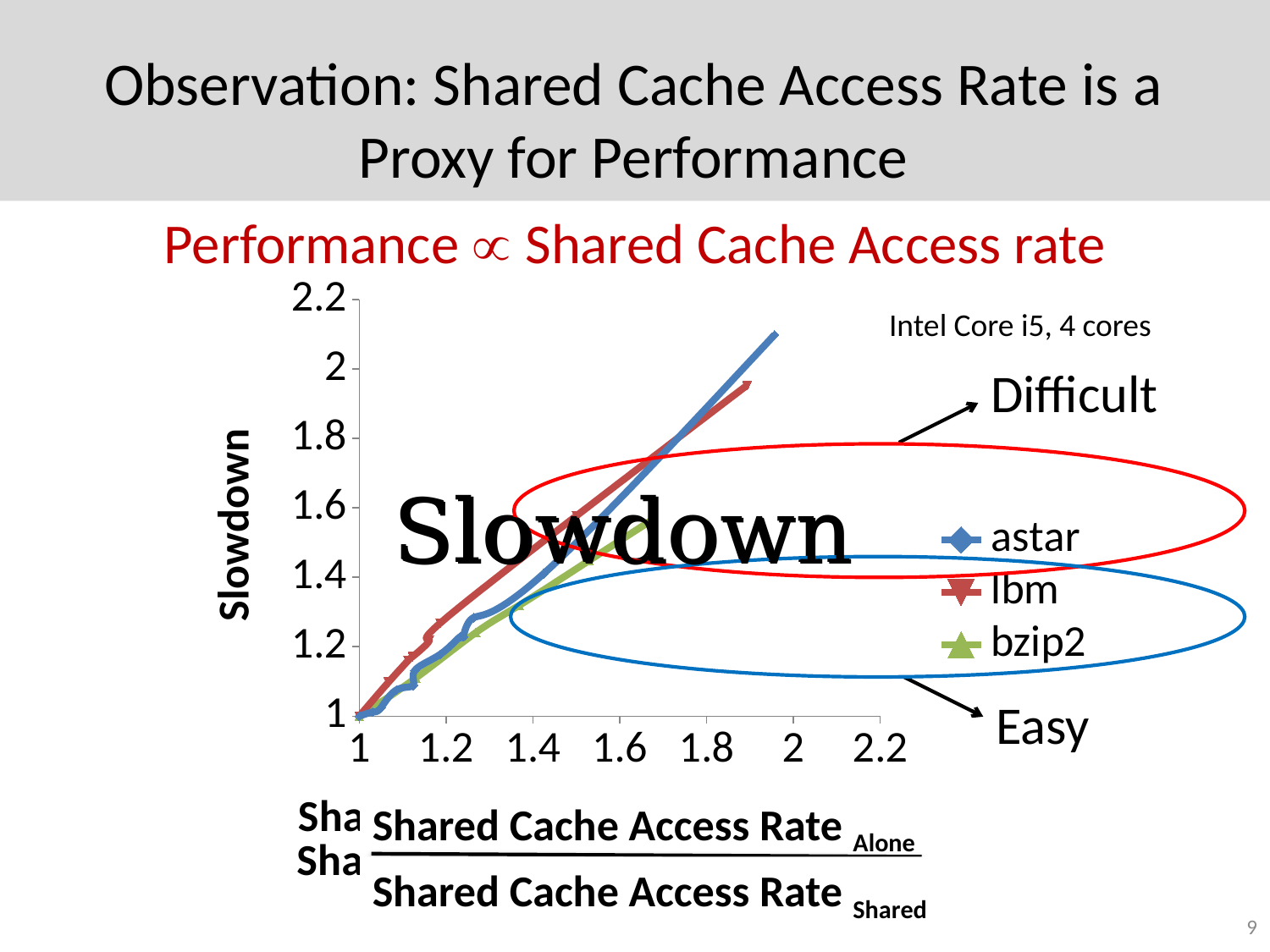
What is the title of the vertical axis of the chart? Slowdown What kind of chart is shown on the slide? line chart Which series reaches the lowest maximum slowdown on the chart? bzip2 Is the highest slowdown reached by the astar series greater or less than 2? greater Which series reaches a higher slowdown at the right end of its line, astar or lbm? astar Is the highest slowdown reached by the bzip2 series greater or less than 1.8? less Which series reaches the highest slowdown value on the chart? astar Is the highest slowdown reached by the lbm series greater or less than 2? less What is the highest tick value shown on the vertical axis of the chart? 2.2 Which series are listed in the chart legend? astar, lbm, bzip2 How many series does the chart legend list? 3 Do the slowdown values rise or fall as the x-axis value increases? rise